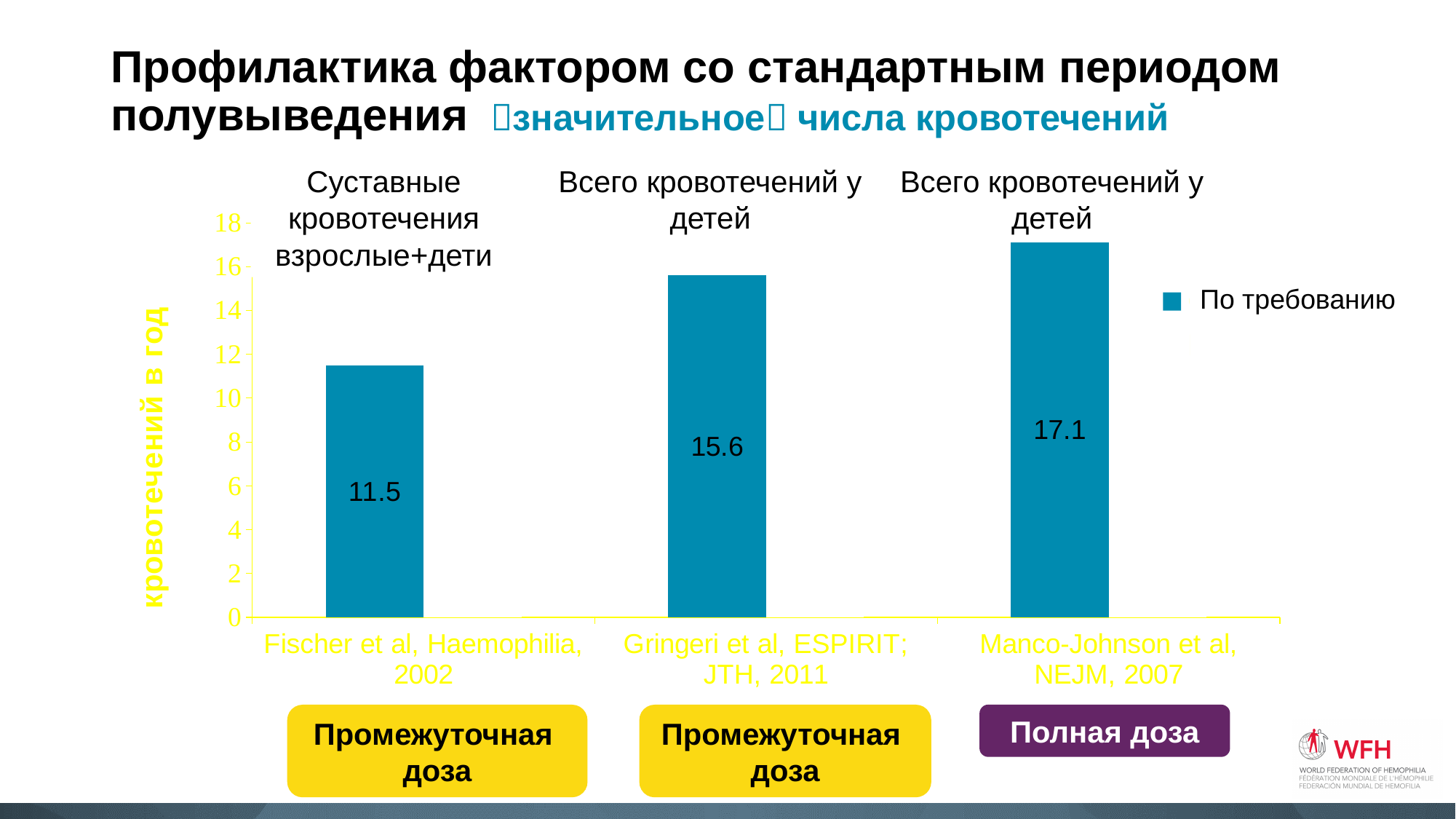
Which is larger: the value for Gringeri et al, ESPIRIT; JTH, 2011 or for Manco-Johnson et al, NEJM, 2007? Manco-Johnson et al, NEJM, 2007 What is the value for Gringeri et al, ESPIRIT; JTH, 2011? 15.6 What is the difference between the values for Manco-Johnson et al, NEJM, 2007 and Fischer et al, Haemophilia, 2002? 5.6 How many bars are shown in the chart? 3 What series name does the legend show? По требованию Which study has the highest number of bleeds per year? Manco-Johnson et al, NEJM, 2007 What is the value for Manco-Johnson et al, NEJM, 2007? 17.1 Which study has the lowest number of bleeds per year? Fischer et al, Haemophilia, 2002 What kind of chart is shown on the slide? bar chart What is the difference between the values for Gringeri et al, ESPIRIT; JTH, 2011 and Fischer et al, Haemophilia, 2002? 4.1 Is the value for Fischer et al, Haemophilia, 2002 greater or less than 12? less What is the value for Fischer et al, Haemophilia, 2002? 11.5